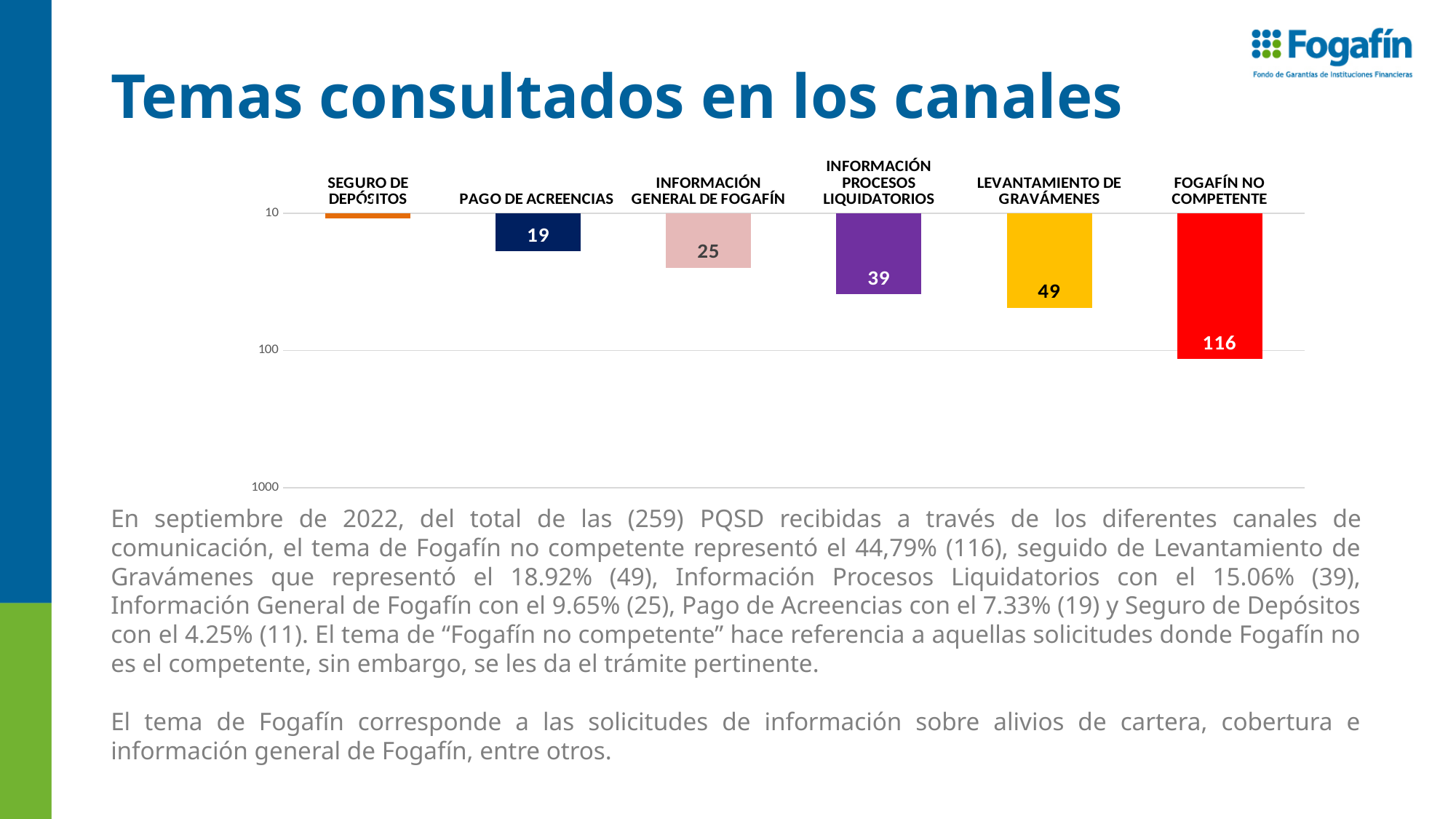
Which category has the highest value? FOGAFÍN NO COMPETENTE What is the value for PAGO DE ACREENCIAS? 19 What is the difference between INFORMACIÓN PROCESOS LIQUIDATORIOS and INFORMACIÓN GENERAL DE FOGAFÍN? 14 What is the value for LEVANTAMIENTO DE GRAVÁMENES? 49 Which is larger, INFORMACIÓN PROCESOS LIQUIDATORIOS or INFORMACIÓN GENERAL DE FOGAFÍN? INFORMACIÓN PROCESOS LIQUIDATORIOS What is the value for INFORMACIÓN GENERAL DE FOGAFÍN? 25 How many categories are shown in the chart? 6 What kind of chart is shown on the slide? bar chart Is the value for FOGAFÍN NO COMPETENTE greater or less than 100? greater Which category has the lowest value? SEGURO DE DEPÓSITOS What is the difference between FOGAFÍN NO COMPETENTE and LEVANTAMIENTO DE GRAVÁMENES? 67 What is the value for FOGAFÍN NO COMPETENTE? 116